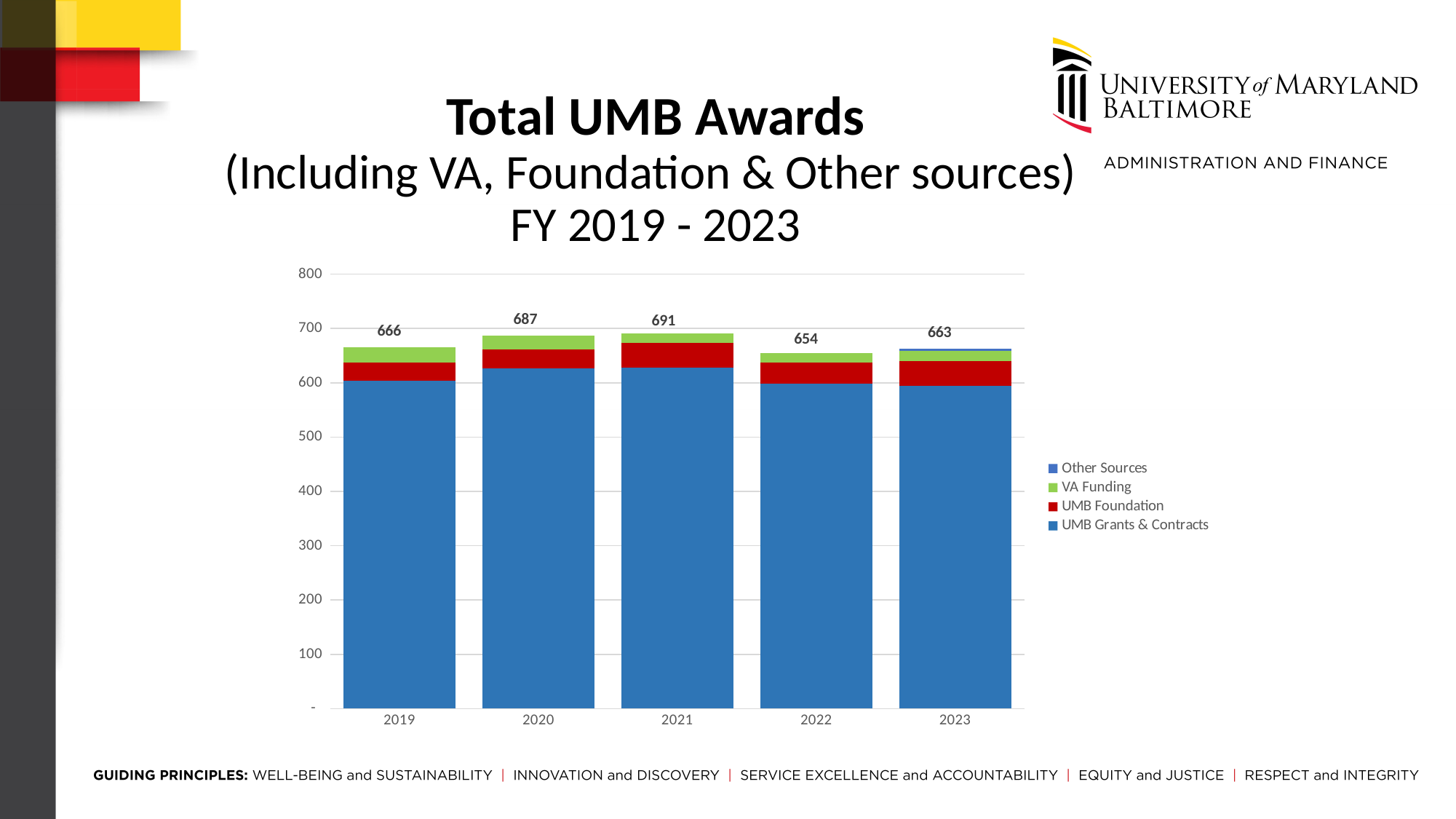
What kind of chart is shown on the slide? Stacked bar chart How many fiscal years are shown on the x axis? 5 What is the total UMB awards value shown for 2021? 691 Is the UMB Grants & Contracts value for 2019 greater or less than 500? greater What is the difference between the total for 2021 and the total for 2022? 37 Which fiscal year has the lowest total UMB awards? 2022 Which fiscal year has the highest total UMB awards? 2021 How many series does the legend list? 4 What is the total UMB awards value shown for 2022? 654 What is the difference between the total for 2020 and the total for 2019? 21 What is the total UMB awards value shown for 2019? 666 Which is larger, the total for 2020 or the total for 2023? 2020